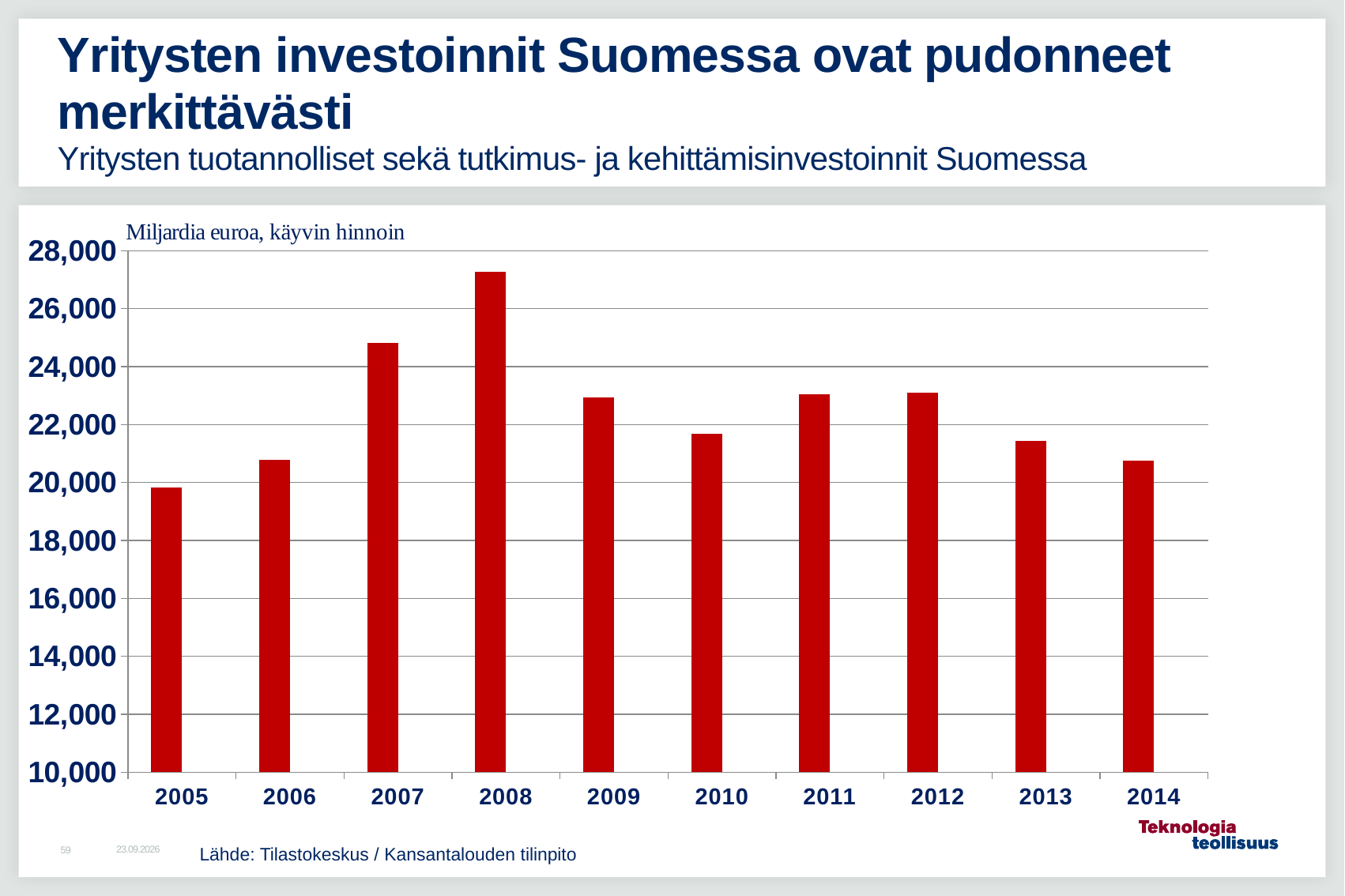
What unit label is printed above the y axis of the chart? Miljardia euroa, käyvin hinnoin What kind of chart is shown on the slide? bar chart Is the value for 2013 greater or less than 22,000? less Is the value for 2005 greater or less than 20,000? less Which is larger, the value for 2007 or the value for 2009? 2007 Which year has the highest value in the chart? 2008 Which year has the lowest value in the chart? 2005 Is the value for 2007 greater or less than 24,000? greater Do the values rise or fall from 2005 to 2008? rise How many years are shown on the x axis of the chart? 10 Do the values rise or fall from 2012 to 2014? fall